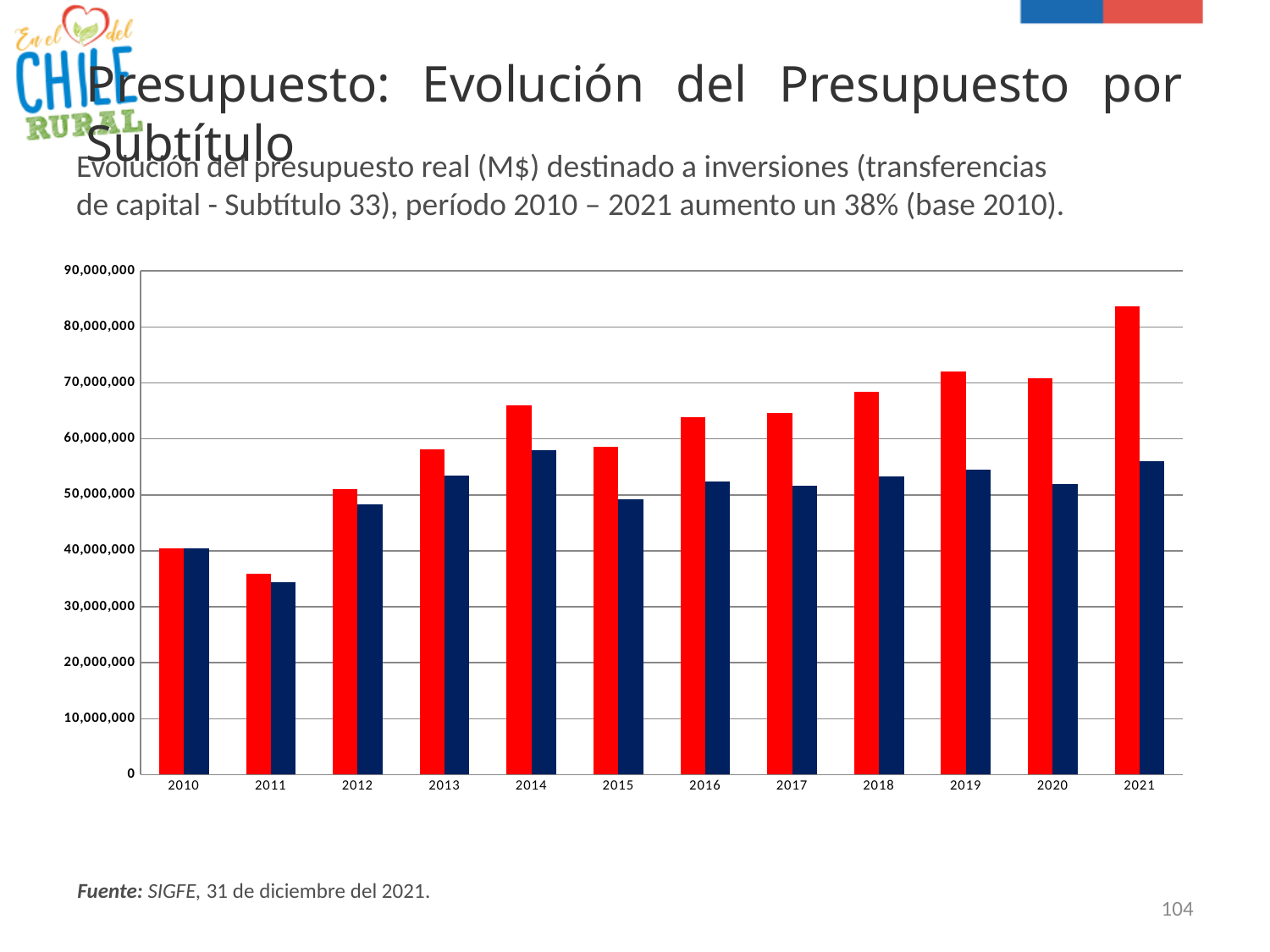
For 2021, which bar is larger, the red one or the dark blue one? red How many series of bars (colours) are plotted for each year? 2 Do the red bars generally rise or fall from 2010 to 2021? rise In which year is the dark blue bar the lowest? 2011 What kind of chart is shown on the slide? bar chart Is the red bar for 2019 greater or less than 70,000,000? greater How many years are shown on the x axis of the chart? 12 Is the red bar for 2021 greater or less than 80,000,000? greater Is the red bar for 2011 greater or less than 40,000,000? less In which year is the red bar the highest? 2021 In which year is the red bar the lowest? 2011